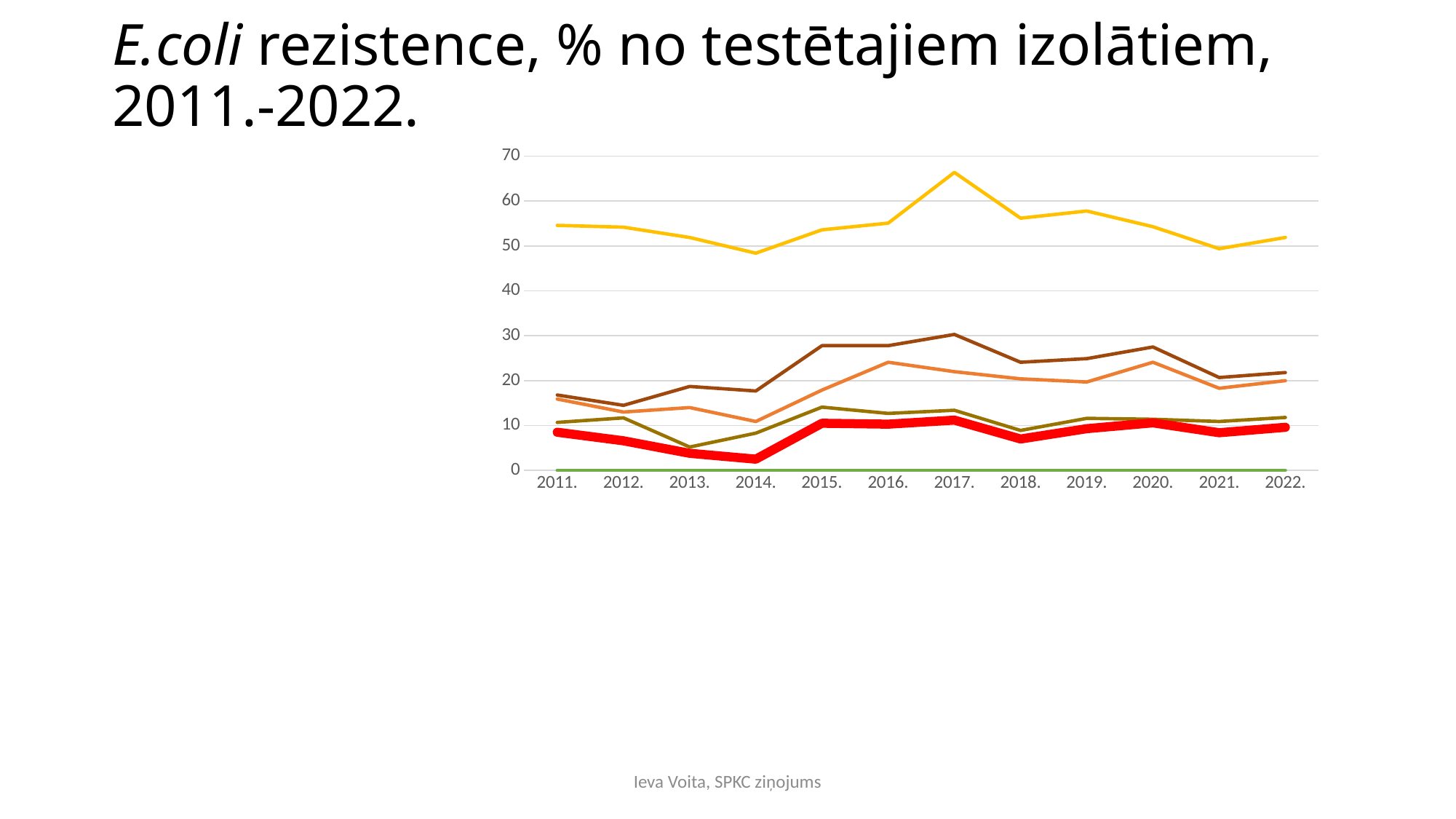
Which line is higher in 2016, the yellow line or the dark brown line? the yellow line Is the value of the yellow line in 2017 greater or less than 60? greater What is the title of the slide containing the chart? E.coli rezistence, % no testētajiem izolātiem, 2011.-2022. What kind of chart is shown on the slide? line chart In which year does the thick red line reach its lowest value? 2014. Is the value of the yellow line in 2014 greater or less than 50? less In which year does the yellow (top) line reach its highest value? 2017. How many years are shown on the x axis of the chart? 12 Does the yellow line rise or fall between 2014 and 2017? rise What is the first year shown on the x axis? 2011.